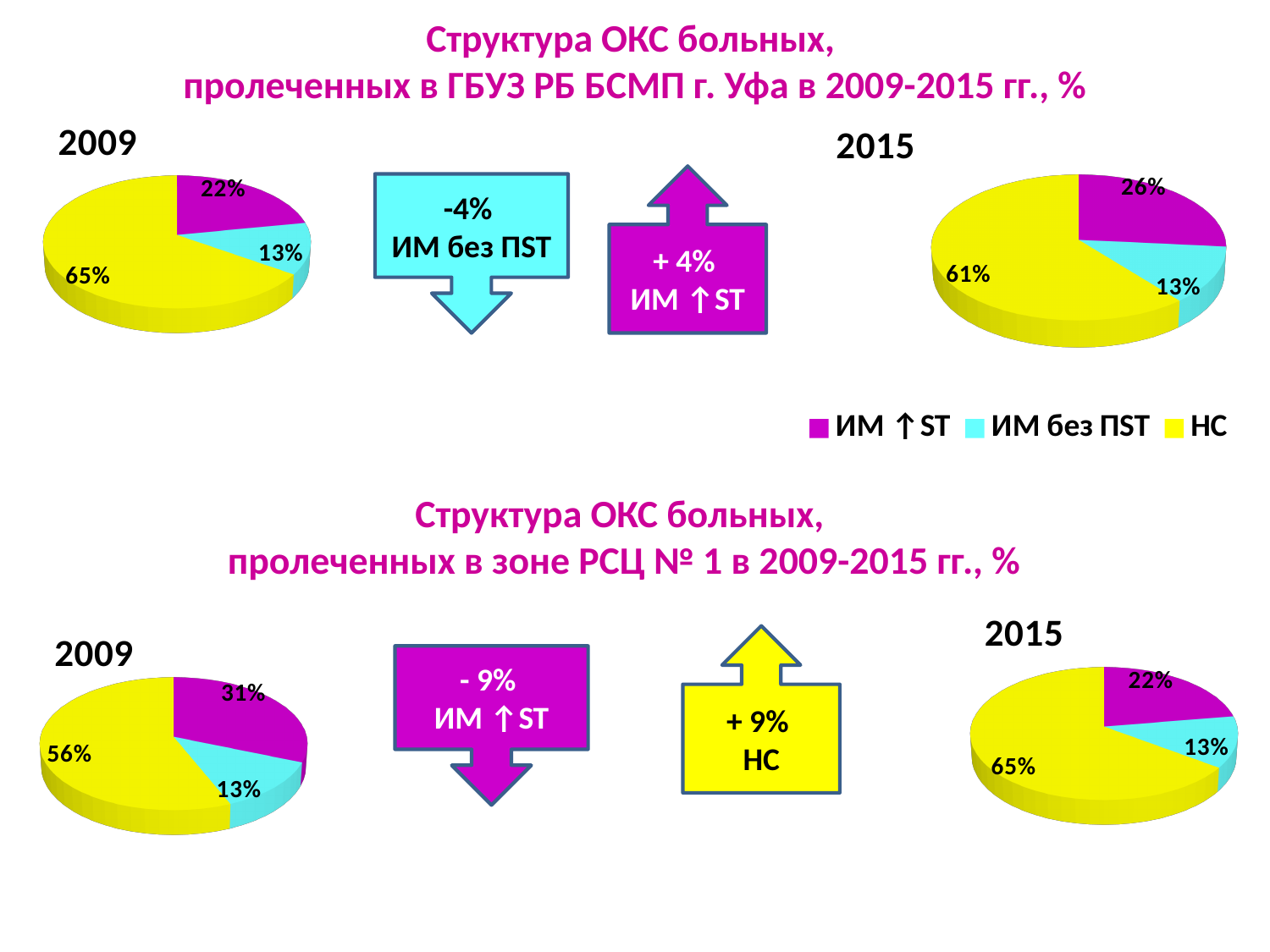
Comparing the ИМ ↑ST slices in the two top pie charts (БСМП г. Уфа), which year has the larger share, 2009 or 2015? 2015 What type of chart is used to show the structure of ОКС patients on this slide? Pie chart In the bottom-left pie chart (зона РСЦ № 1, 2009), what share is ИМ ↑ST? 31% In the top-right pie chart (БСМП г. Уфа, 2015), what share is ИМ ↑ST? 26% How many slices does the bottom-right pie chart (зона РСЦ № 1, 2015) have? 3 In the bottom-left pie chart (зона РСЦ № 1, 2009), what is the difference between the НС share and the ИМ ↑ST share? 25% In the top-left pie chart (БСМП г. Уфа, 2009), what is the difference between the НС share and the ИМ ↑ST share? 43% In the bottom-left pie chart (зона РСЦ № 1, 2009), which category has the smallest slice? ИМ без ПST How many entries does the legend list? 3 In the bottom-right pie chart (зона РСЦ № 1, 2015), what share is НС? 65% In the top-right pie chart (БСМП г. Уфа, 2015), which category has the largest slice? НС In the top-left pie chart (БСМП г. Уфа, 2009), what share is НС? 65%